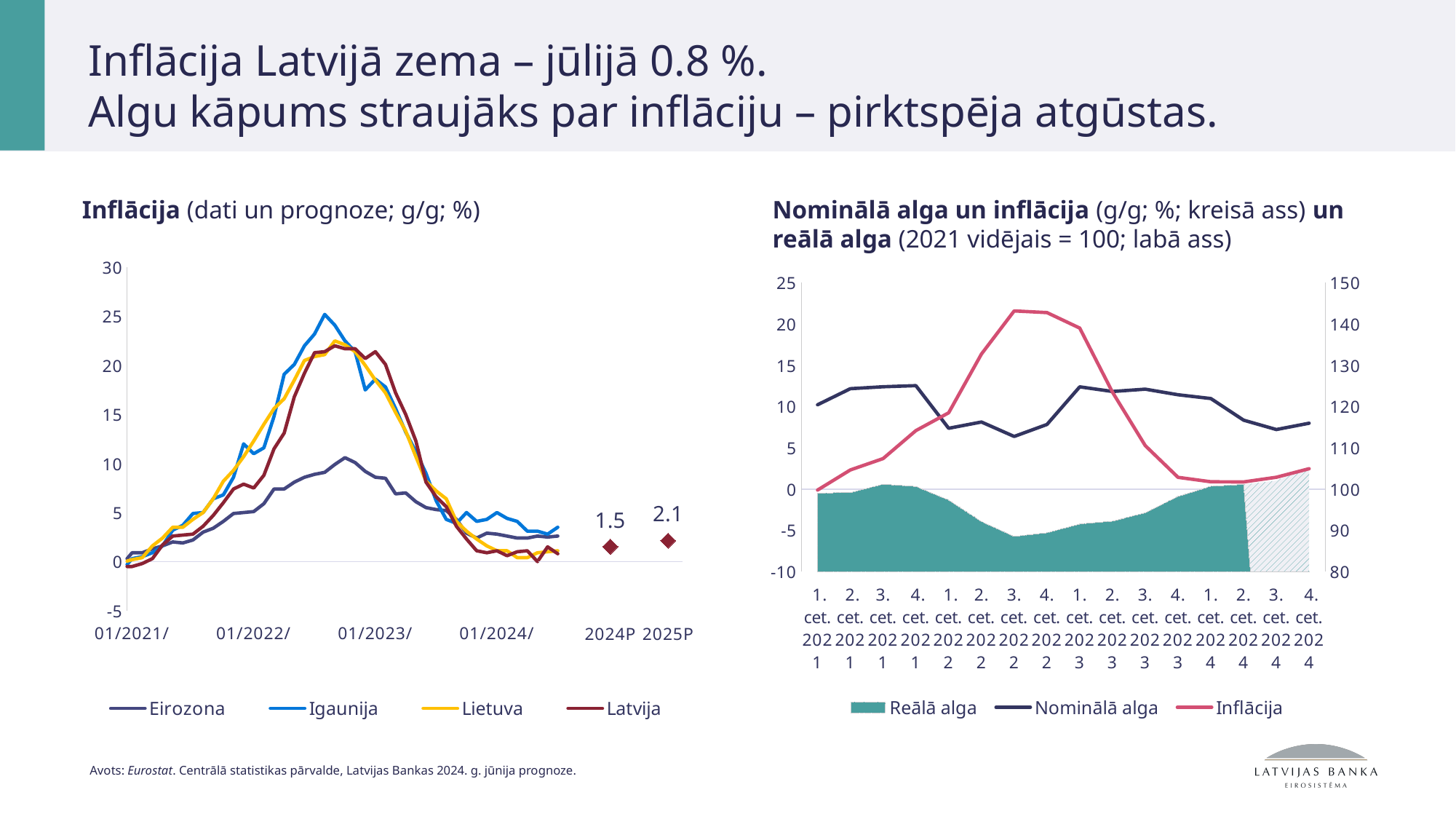
How many series does the legend of the right chart 'Nominālā alga un inflācija' list? 3 In the left chart 'Inflācija', which forecast value is larger, 2024P or 2025P? 2025P In the right chart 'Nominālā alga un inflācija', does Inflācija rise or fall from 3. cet. 2022 to 4. cet. 2023? Fall In the left chart 'Inflācija', what is the difference between the 2025P and 2024P forecast values? 0.6 How many series does the legend of the left chart 'Inflācija' list? 4 In the left chart 'Inflācija', what is the forecast value shown for 2025P? 2.1 In the right chart 'Nominālā alga un inflācija', is the peak value of Inflācija greater or less than 20 on the left axis? greater In the right chart 'Nominālā alga un inflācija', which series is drawn as a filled area rather than a line? Reālā alga How many quarters are shown on the x axis of the right chart 'Nominālā alga un inflācija'? 16 In the left chart 'Inflācija', which series reaches the highest peak? Igaunija In the left chart 'Inflācija', what is the forecast value shown for 2024P? 1.5 What kind of chart is the left chart 'Inflācija'? Line chart